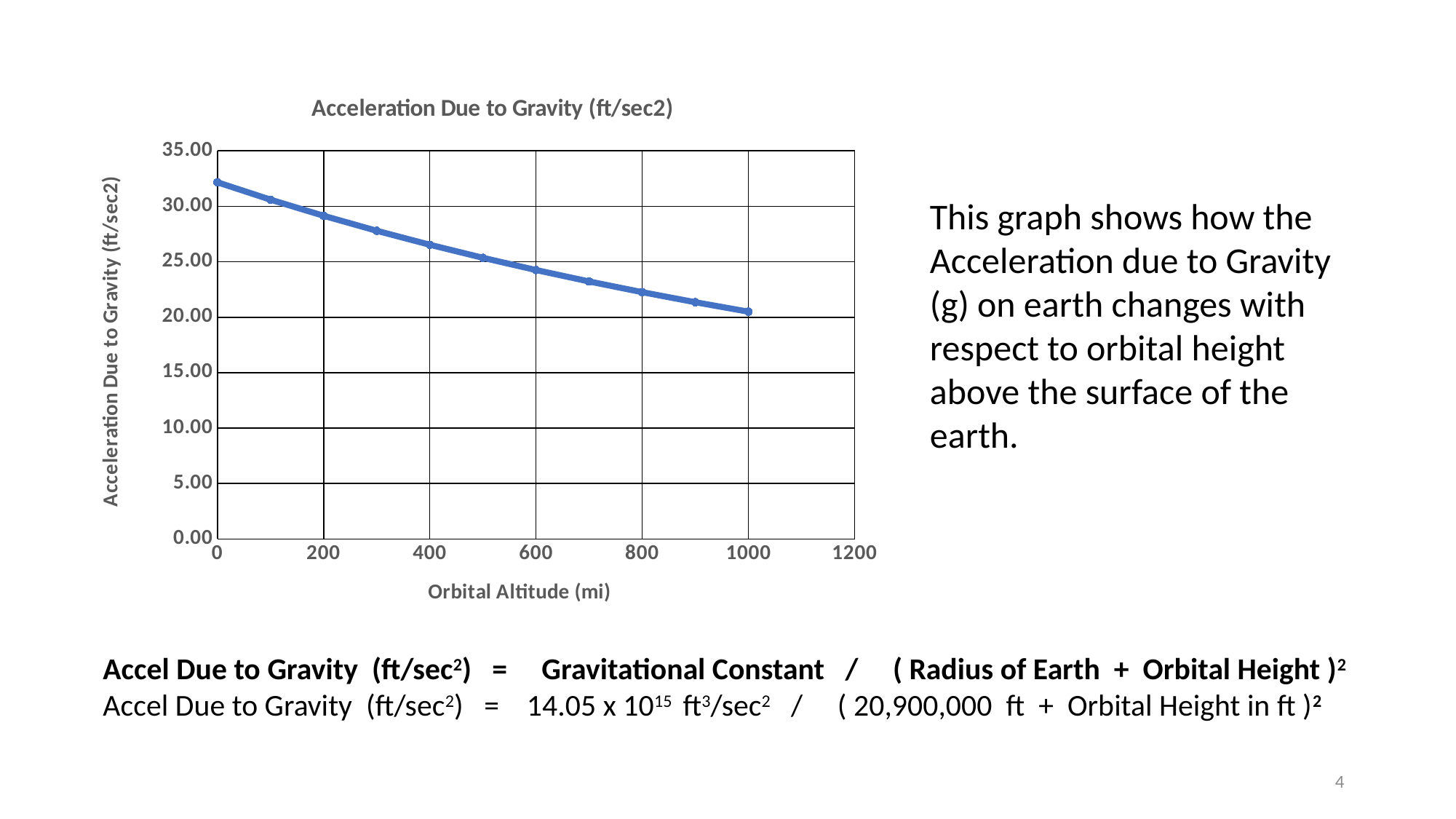
At which orbital altitude is the acceleration due to gravity lowest? 1000 How many data points are plotted on the line? 11 What is the title of the chart? Acceleration Due to Gravity (ft/sec2) Does the acceleration due to gravity rise or fall as orbital altitude increases? fall What kind of chart is shown on the slide? line chart Which has the larger acceleration due to gravity, an orbital altitude of 200 mi or 800 mi? 200 mi Is the value at an orbital altitude of 800 mi greater or less than 20.00? greater At which orbital altitude is the acceleration due to gravity highest? 0 Is the value at an orbital altitude of 0 mi greater or less than 30.00? greater Is the value at an orbital altitude of 1000 mi greater or less than 25.00? less What is the label of the x axis of the chart? Orbital Altitude (mi)